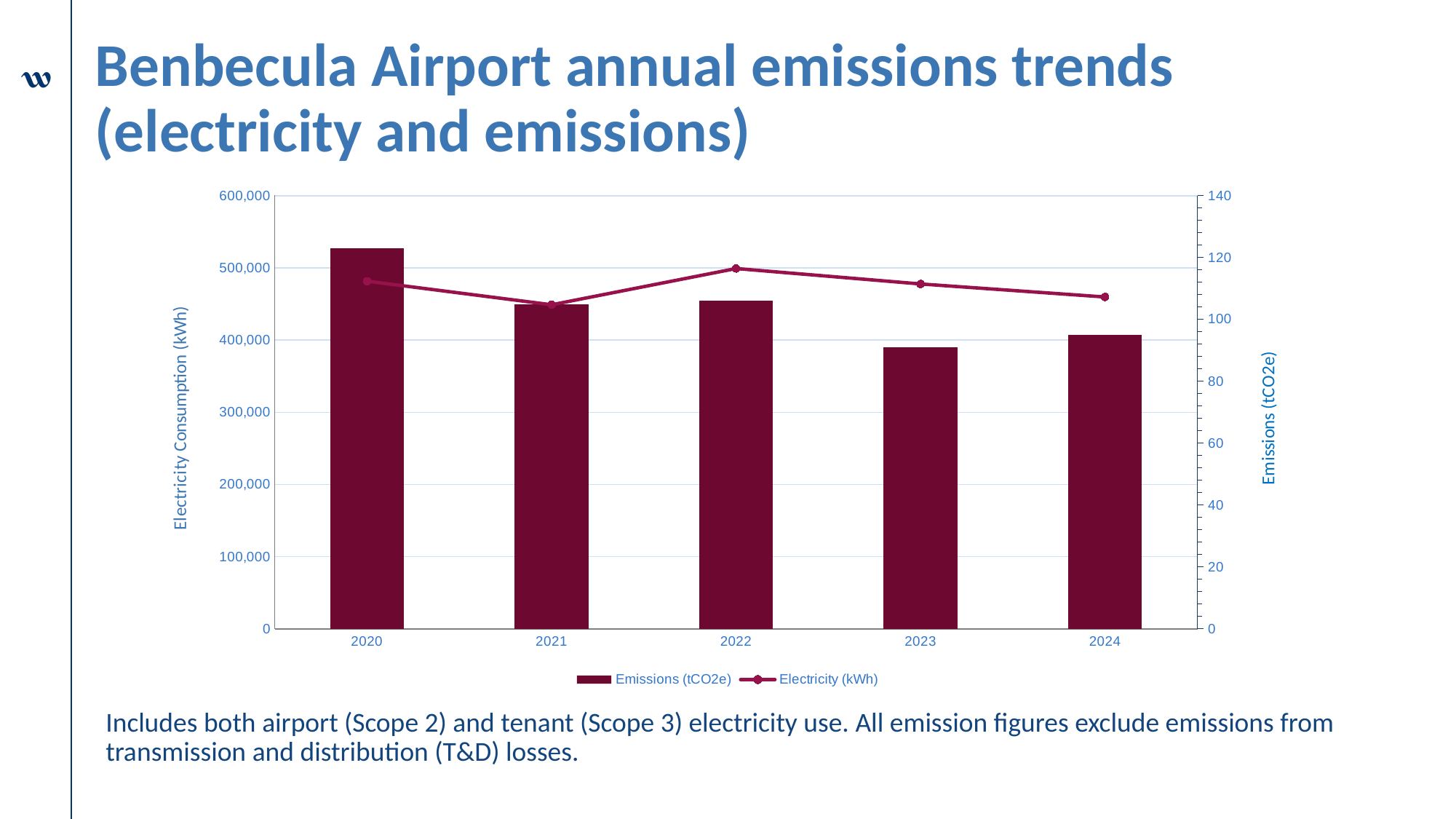
What is the title of the left vertical axis? Electricity Consumption (kWh) How many series does the chart's legend list? 2 Which year has a taller bar, 2020 or 2021? 2020 Which year has the highest point on the Electricity (kWh) line? 2022 How many years are shown on the x axis of the chart? 5 Which year has the shortest bar in the chart? 2023 Is the bar for 2020 greater or less than 500,000 on the left axis? greater Which year has the tallest bar in the chart? 2020 What kind of chart is used to plot the Emissions (tCO2e) series? bar chart Is the Electricity (kWh) line point for 2021 greater or less than 120 on the right axis? less Which year has the lowest point on the Electricity (kWh) line? 2021 Is the bar for 2023 greater or less than 400,000 on the left axis? less